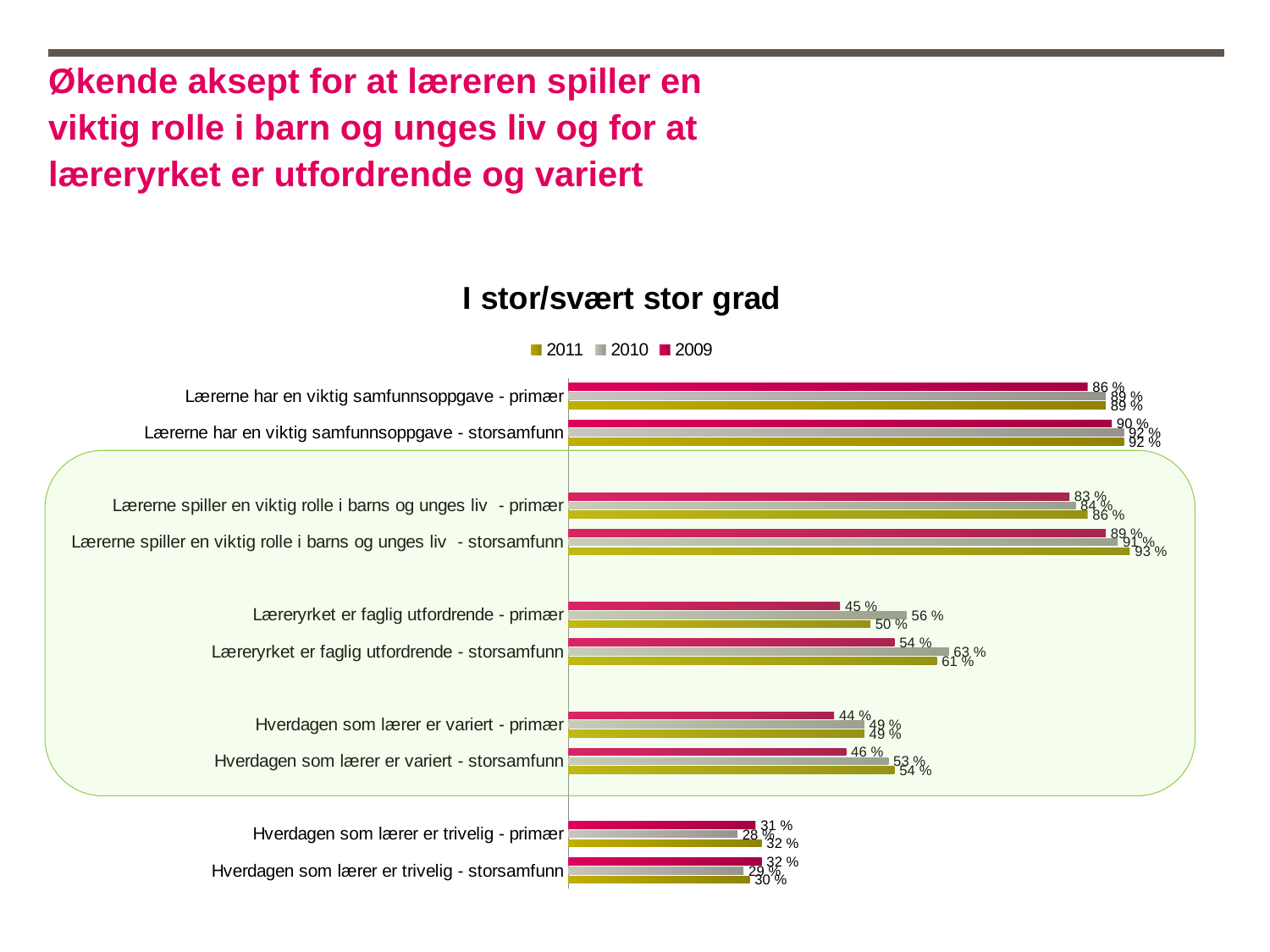
How many series does the legend list? 3 What is the title of the chart? I stor/svært stor grad What is the 2009 value for 'Læreryrket er faglig utfordrende - primær'? 45 % Which is larger for 'Læreryrket er faglig utfordrende - storsamfunn': the 2009 value or the 2010 value? 2010 What kind of chart is shown on the slide? bar chart Which category has the lowest 2009 value? Hverdagen som lærer er trivelig - primær What is the 2010 value for 'Læreryrket er faglig utfordrende - primær'? 56 % What is the 2011 value for 'Læreryrket er faglig utfordrende - storsamfunn'? 61 % What is the 2009 value for 'Hverdagen som lærer er variert - primær'? 44 % How many categories are plotted in the chart? 10 What is the difference between the 2010 and 2009 values for 'Læreryrket er faglig utfordrende - primær'? 11 % What is the 2011 value for 'Lærerne spiller en viktig rolle i barns og unges liv - storsamfunn'? 93 %